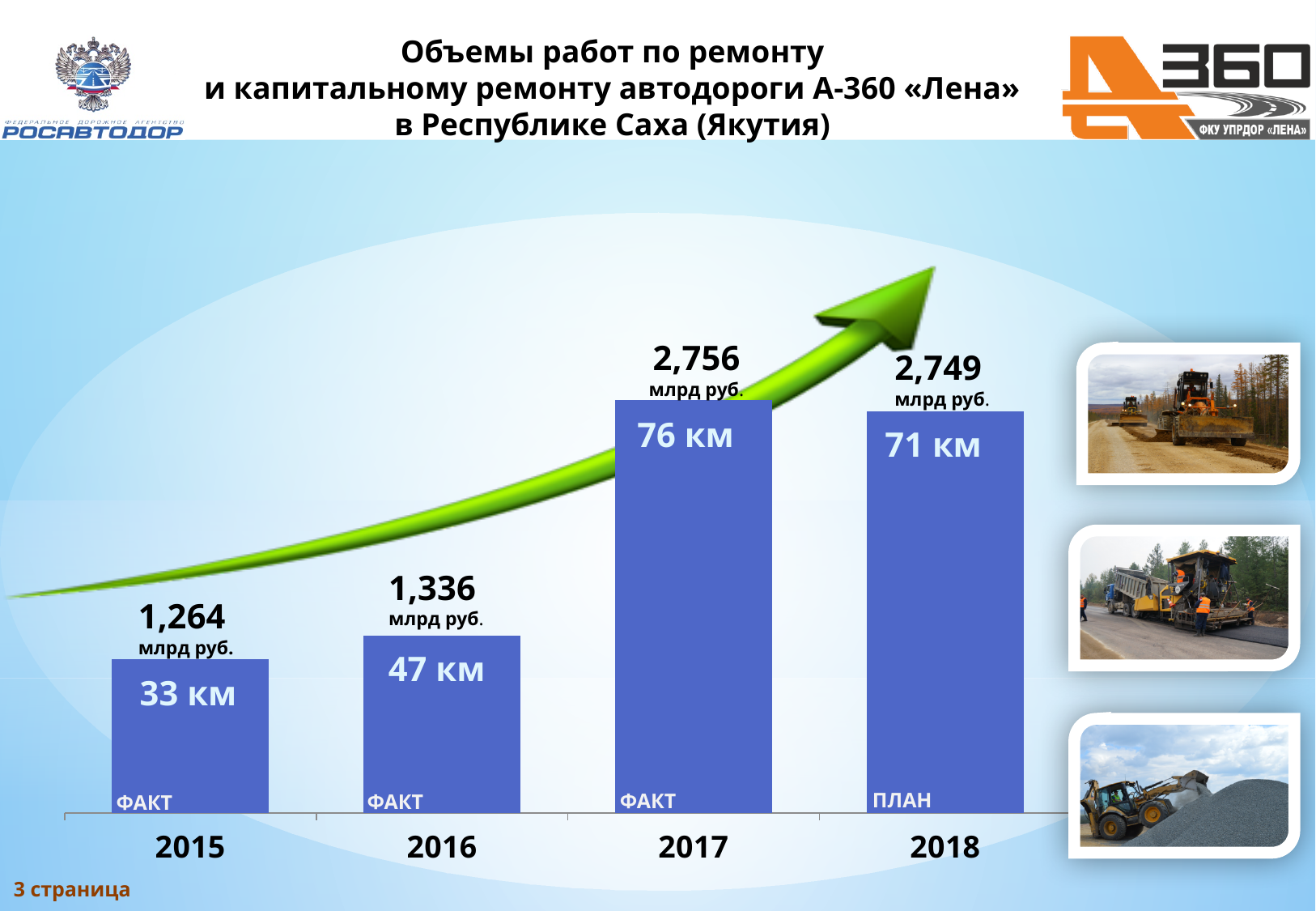
Which year has the lowest number of kilometres? 2015 How many kilometres are planned for 2018? 71 км Which bar is labelled ПЛАН rather than ФАКТ? 2018 What is the value in млрд руб. for 2017? 2,756 млрд руб. What is the difference in kilometres between 2017 and 2015? 43 км What type of chart is shown on the slide? bar chart What is the value in млрд руб. for 2015? 1,264 млрд руб. Do the values in млрд руб. generally rise or fall from 2015 to 2017? rise How many kilometres are shown for 2016? 47 км Which year has the highest value in млрд руб.? 2017 How many years (bars) are shown in the chart? 4 Which year has more kilometres, 2017 or 2018? 2017